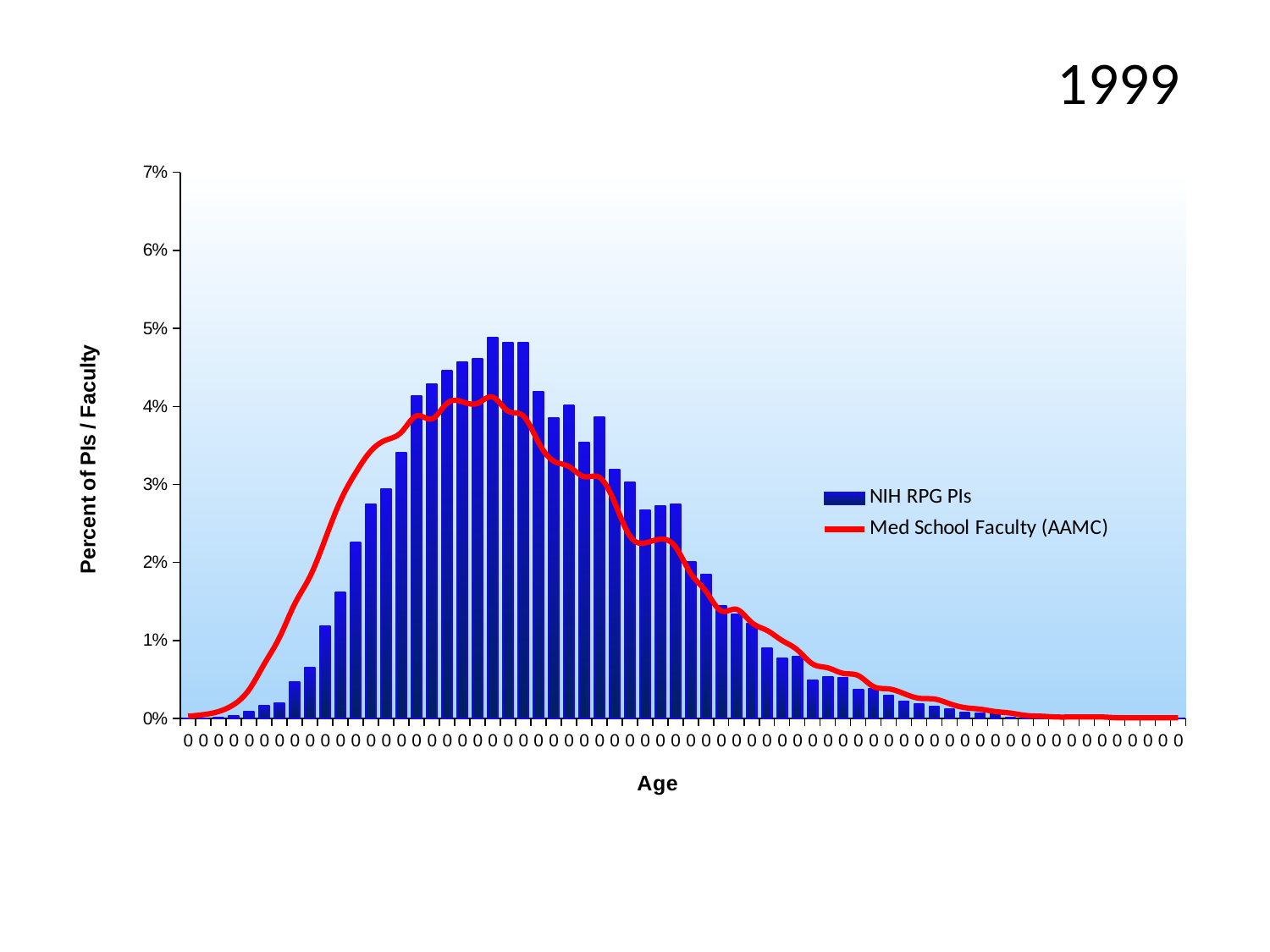
What year is shown as the chart's title? 1999 How many series does the legend list? 2 Which series reaches a higher peak value, NIH RPG PIs or Med School Faculty (AAMC)? NIH RPG PIs Do the NIH RPG PIs bars rise or fall along the x axis after their peak? fall What is the highest value shown on the y axis? 7% Is the peak of the Med School Faculty (AAMC) line greater or less than 5%? less Is the tallest NIH RPG PIs bar greater or less than 4%? greater What are the two series named in the legend? NIH RPG PIs and Med School Faculty (AAMC) What kind of chart is used for the NIH RPG PIs series? bar chart